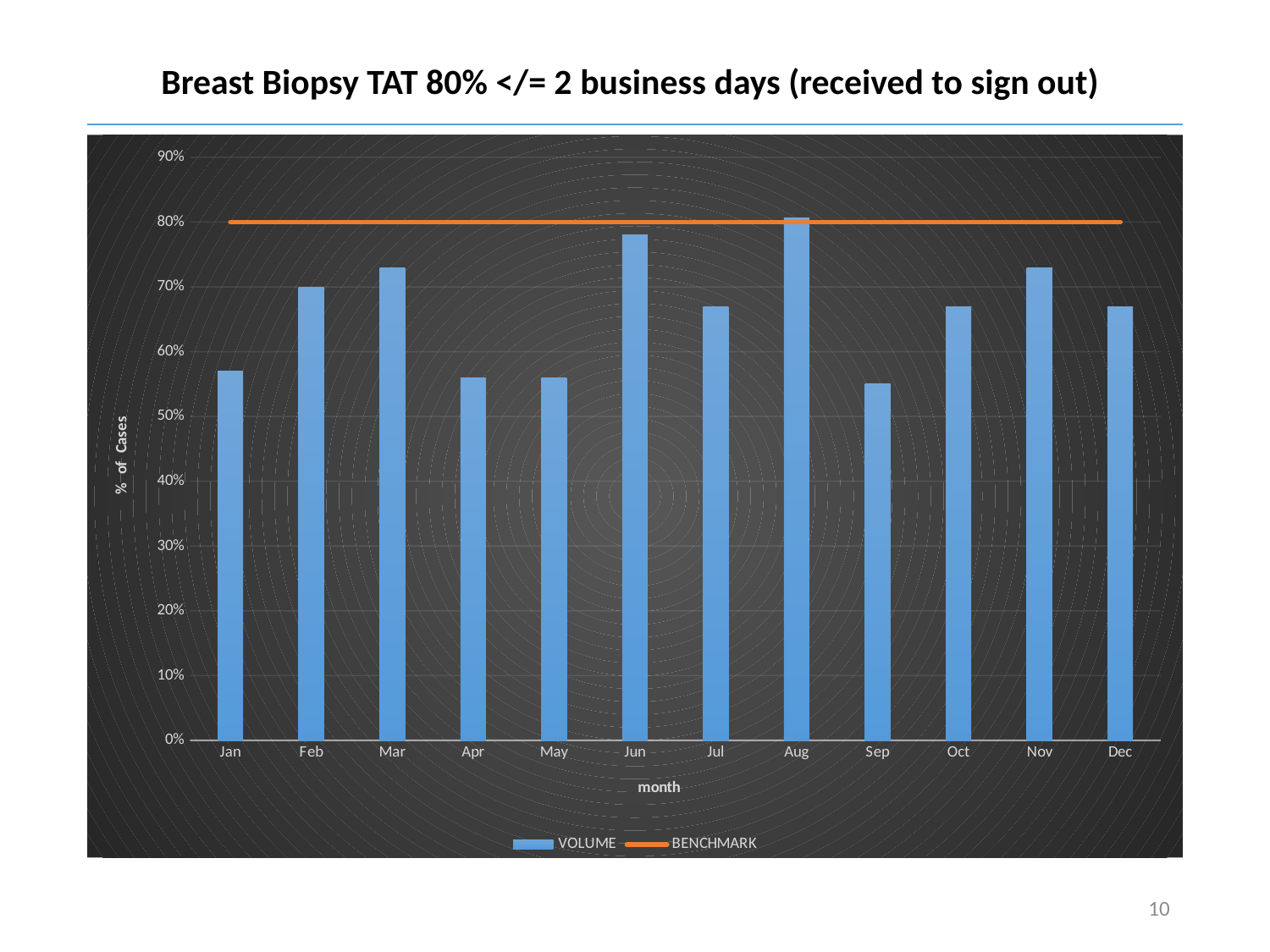
How many series does the chart's legend list? 2 What kind of chart is shown on the slide? combination bar and line chart Which has the larger VOLUME value, Jun or Jul? Jun Which month has the highest VOLUME bar? Aug How many months are shown on the x axis of the chart? 12 Is the VOLUME value for Jun greater or less than 70%? greater Is the VOLUME value for Jan greater or less than 60%? less Which has the larger VOLUME value, Mar or Apr? Mar Is the VOLUME value for Sep greater or less than 60%? less What value does the BENCHMARK line sit at on the y axis? 80% What is the title of the chart's y axis? % of Cases